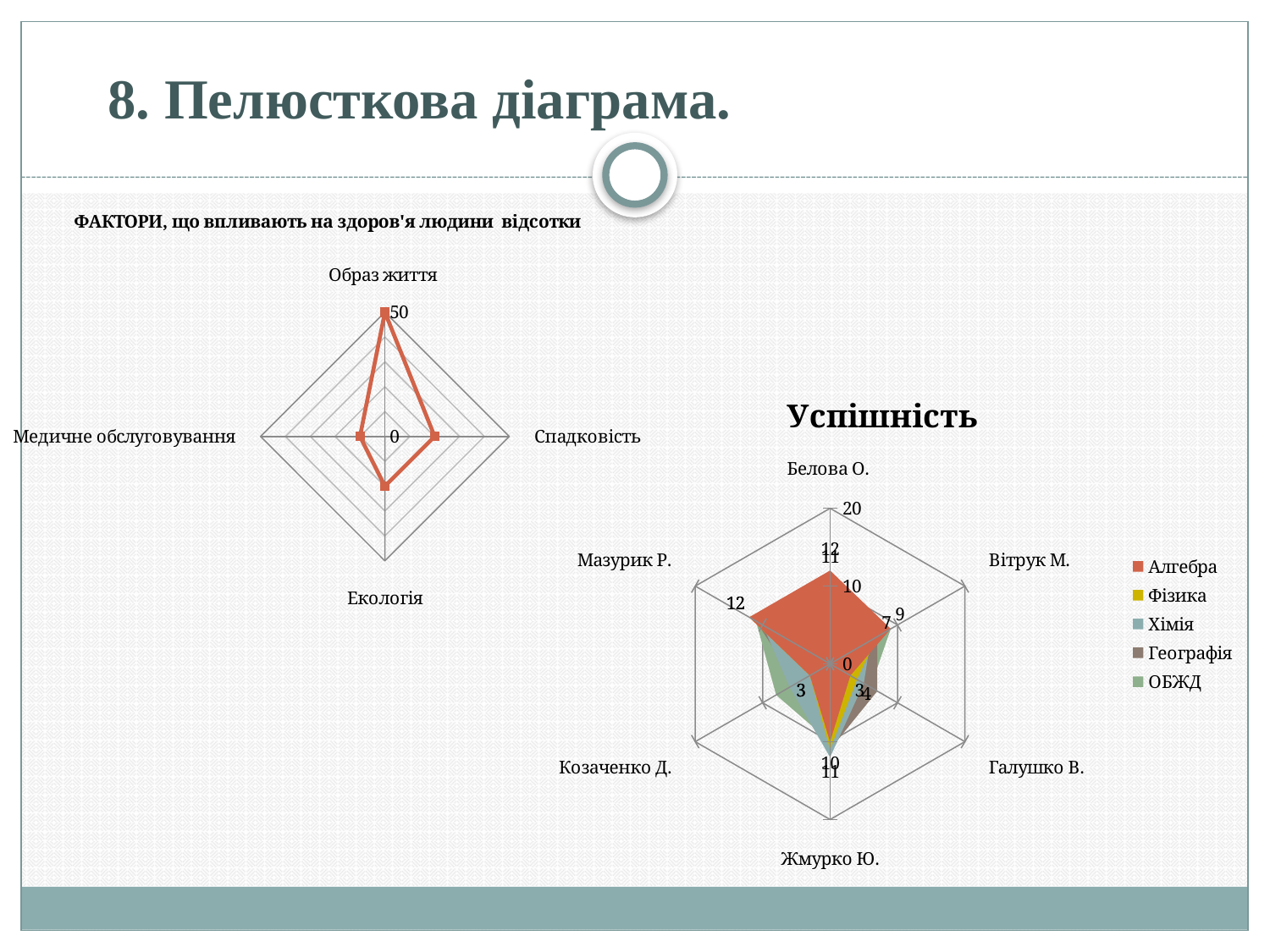
In the right chart (Успішність), how many students (categories) are plotted? 6 In the right chart (Успішність), which series is shown in red? Алгебра In the left chart (ФАКТОРИ, що впливають на здоров'я людини), is the value for Спадковість greater or less than 50? less In the left chart (ФАКТОРИ, що впливають на здоров'я людини), what is the value for Образ життя? 50 In the left chart (ФАКТОРИ, що впливають на здоров'я людини), which is larger: the value for Образ життя or the value for Екологія? Образ життя What kind of chart is the right chart titled "Успішність"? Radar chart In the left chart (ФАКТОРИ, що впливають на здоров'я людини), which category has the highest value? Образ життя In the left chart (ФАКТОРИ, що впливають на здоров'я людини), how many categories are plotted? 4 What kind of chart is the left chart titled "ФАКТОРИ, що впливають на здоров'я людини відсотки"? Radar chart In the right chart (Успішність), how many series does the legend list? 5 In the left chart (ФАКТОРИ, що впливають на здоров'я людини), which category has the lowest value? Медичне обслуговування In the right chart (Успішність), is the Алгебра value for Белова О. greater or less than 10? greater